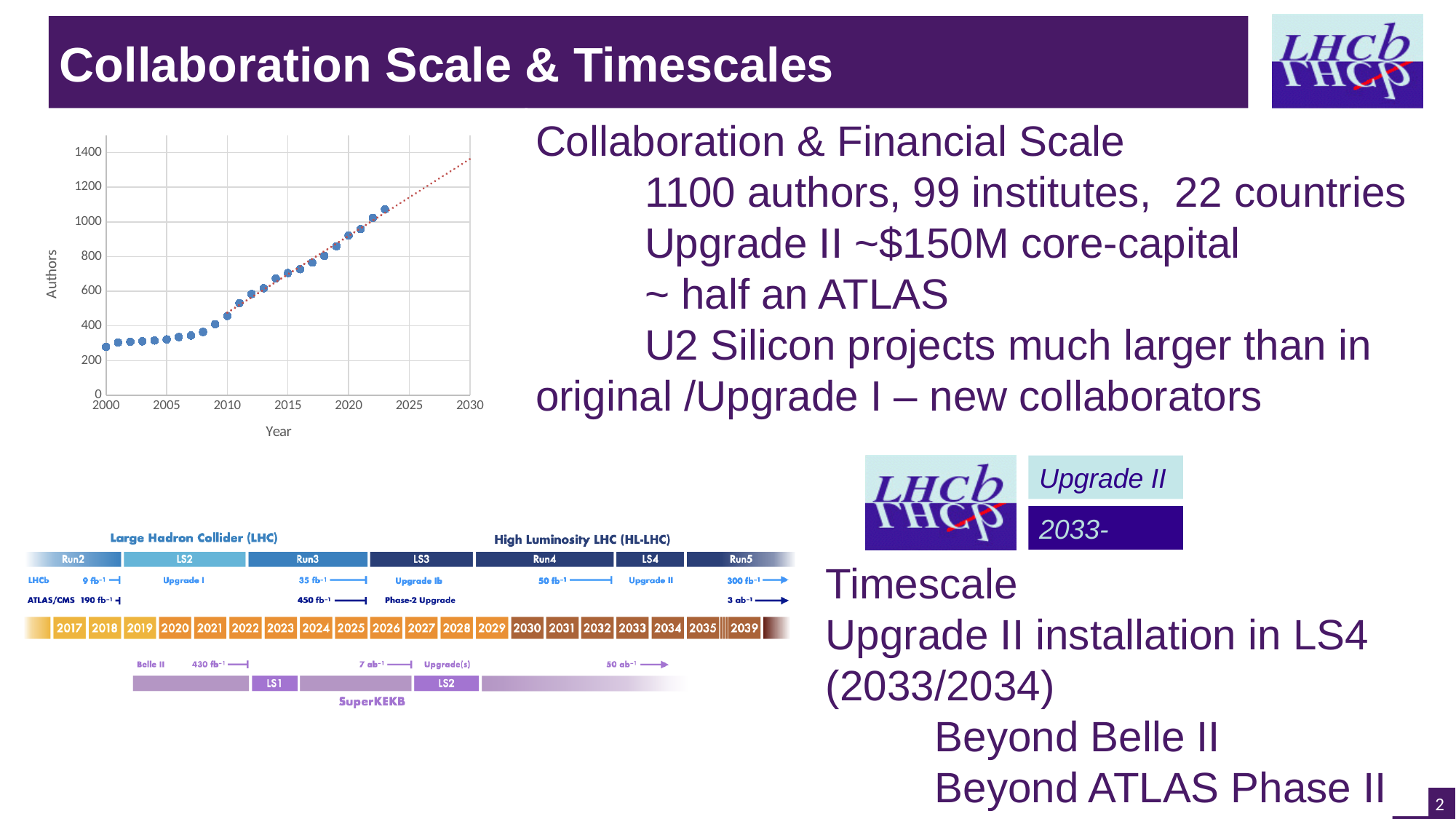
What kind of chart is the Authors vs Year chart on the left of the slide? scatter chart In the Authors vs Year chart, is the value for 2015 greater or less than 600? greater In the Authors vs Year chart, is the value for 2000 greater or less than 400? less In the Authors vs Year chart, is the value for 2010 greater or less than 600? less In the Authors vs Year chart, which year has fewer authors, 2000 or 2015? 2000 What is the label on the horizontal axis of the scatter chart on the left? Year In the Authors vs Year chart, do the number of authors rise or fall as the year increases? rise What is the label on the vertical axis of the scatter chart on the left? Authors In the Authors vs Year chart, which year has more authors, 2010 or 2020? 2020